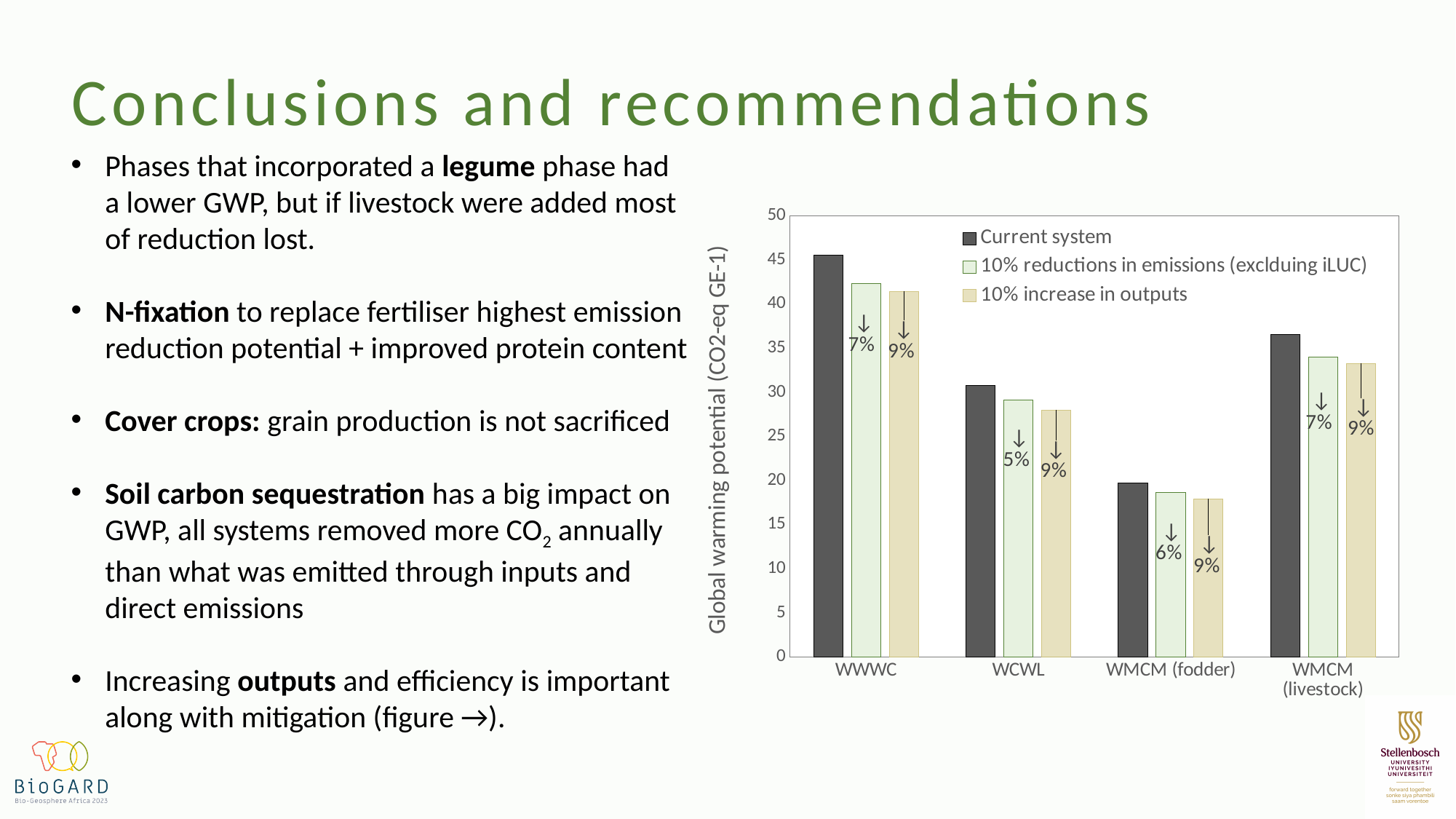
What percentage reduction is labelled on the '10% reductions in emissions (exclduing iLUC)' bar for WCWL? 5% Which is larger: the Current system value for WCWL or for WMCM (livestock)? WMCM (livestock) What kind of chart is shown on the slide? bar chart How many series does the chart's legend list? 3 What is the label of the chart's y axis? Global warming potential (CO2-eq GE-1) Which category has the lowest Current system value? WMCM (fodder) Which category has the highest Current system value? WWWC What percentage reduction is labelled on the '10% increase in outputs' bar for WMCM (fodder)? 9% How many categories are shown on the x axis of the chart? 4 Is the Current system value for WMCM (livestock) greater or less than 35? greater Is the Current system value for WWWC greater or less than 40? greater